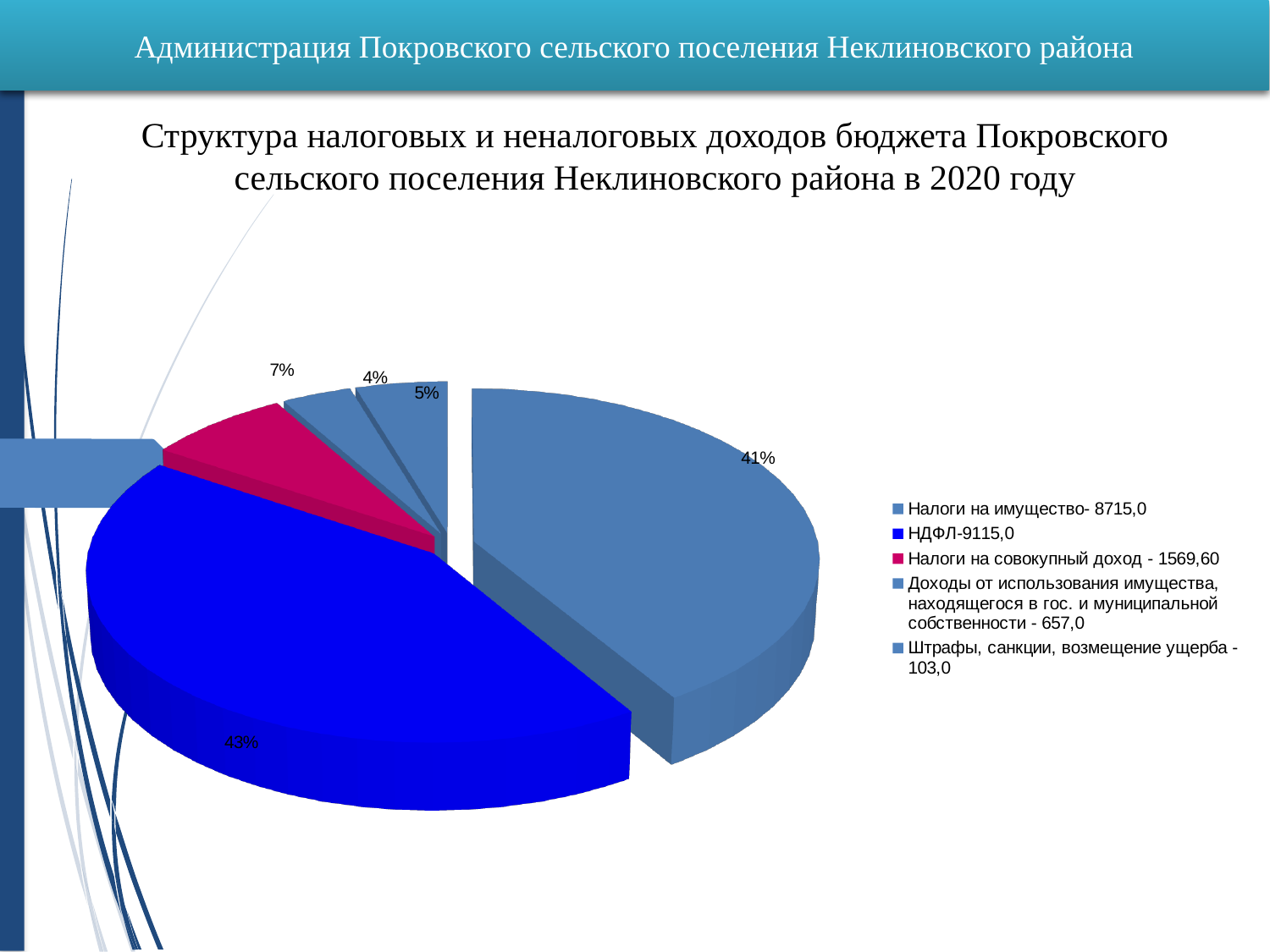
What kind of chart is shown on the slide? pie chart What percentage share does the Налоги на имущество slice have? 41% What value is given in the legend for Штрафы, санкции, возмещение ущерба? 103,0 Which is larger: the share for НДФЛ or the share for Налоги на имущество? НДФЛ What is the difference in percentage points between the НДФЛ share and the Налоги на имущество share? 2 What percentage share does the Налоги на совокупный доход slice have? 7% What percentage share does the НДФЛ slice have? 43% How many slices does the pie chart have? 5 How many entries does the legend list? 5 What value is given in the legend for Налоги на совокупный доход? 1569,60 What colour is the НДФЛ slice? blue Which category has the largest share of the pie? НДФЛ